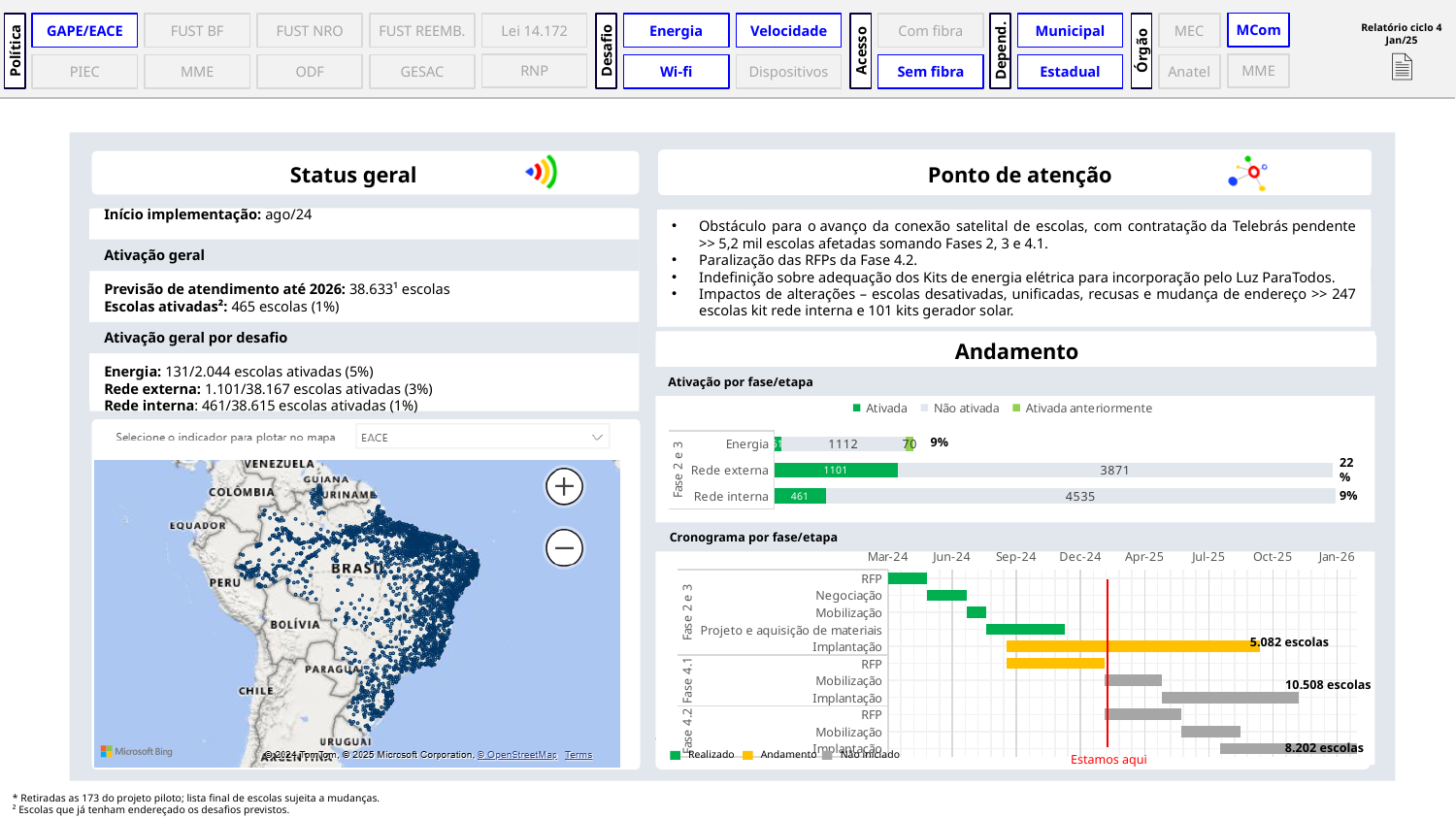
In the 'Ativação por fase/etapa' chart, which category has the highest 'Não ativada' value? Rede interna In the 'Ativação por fase/etapa' chart, what is the 'Ativada' value for Rede externa? 1101 In the 'Ativação por fase/etapa' chart, is the 'Ativada' value larger for Rede externa or Rede interna? Rede externa In the 'Ativação por fase/etapa' chart, what is the difference between the 'Não ativada' values of Rede interna and Rede externa? 664 In the 'Ativação por fase/etapa' chart, what is the total of the Rede externa bar (Ativada plus Não ativada)? 4972 In the 'Ativação por fase/etapa' chart, what is the 'Não ativada' value for Rede externa? 3871 In the 'Ativação por fase/etapa' chart, what is the 'Ativada' value for Rede interna? 461 How many categories are shown in the 'Ativação por fase/etapa' chart? 3 In the 'Ativação por fase/etapa' chart, what is the 'Não ativada' value for Energia? 1112 How many series does the legend of the 'Ativação por fase/etapa' chart list? 3 In the 'Ativação por fase/etapa' chart, which category has the lowest 'Ativada' value? Energia What kind of chart is 'Ativação por fase/etapa'? Stacked horizontal bar chart